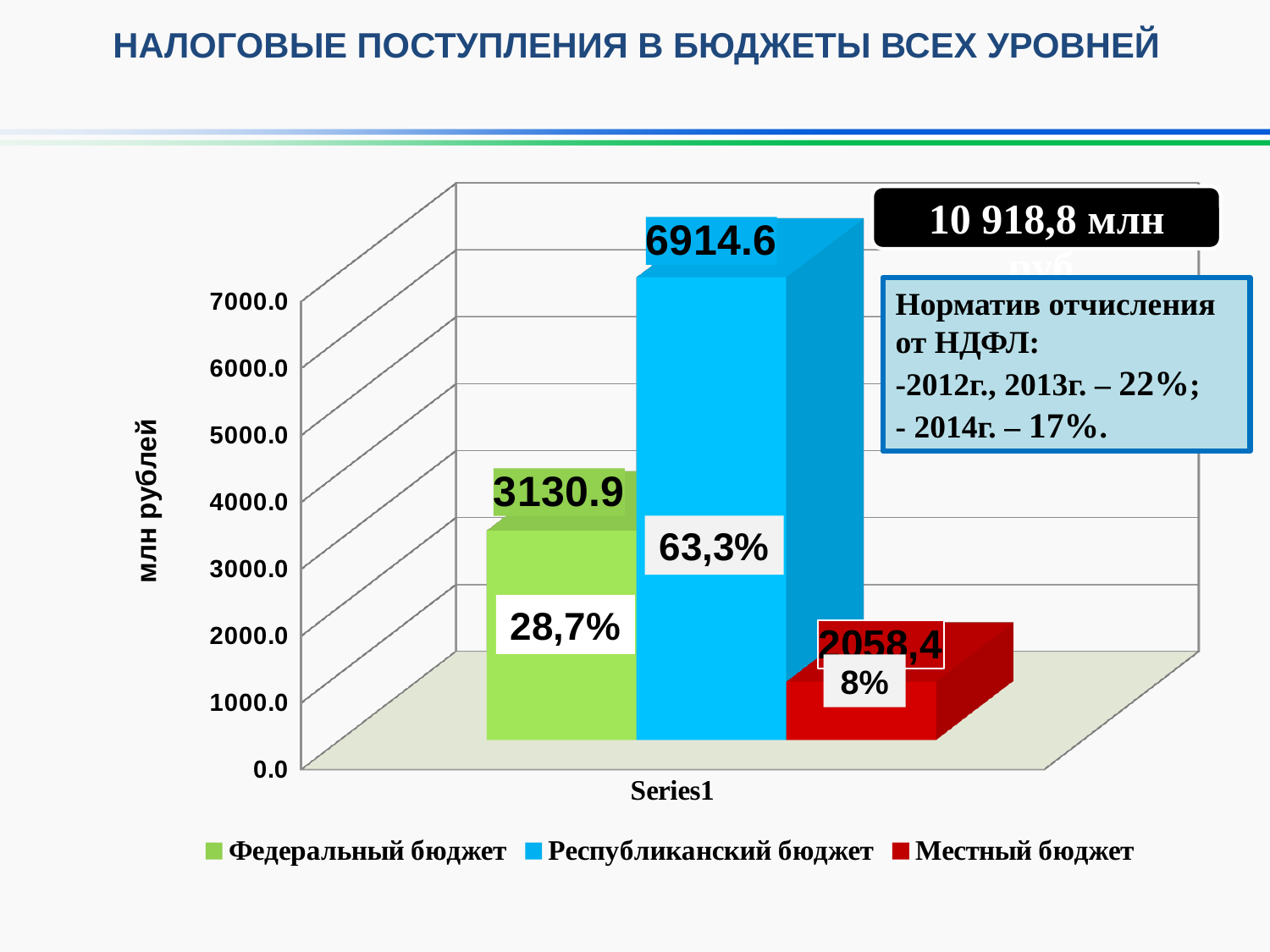
What type of chart is shown on the slide? Bar chart What is the difference between the values for Республиканский бюджет and Федеральный бюджет? 3783.7 What percentage share is printed on the bar for Республиканский бюджет? 63,3% How many series does the legend list? 3 Which budget has the highest tax revenue on the chart? Республиканский бюджет Which is larger, the value for Федеральный бюджет or the value for Местный бюджет? Федеральный бюджет What is the value shown for Местный бюджет? 2058,4 What is the value shown for Республиканский бюджет? 6914.6 What is the label of the vertical axis? млн рублей What percentage share is printed on the bar for Федеральный бюджет? 28,7% Which budget has the lowest tax revenue on the chart? Местный бюджет What is the value shown for Федеральный бюджет? 3130.9